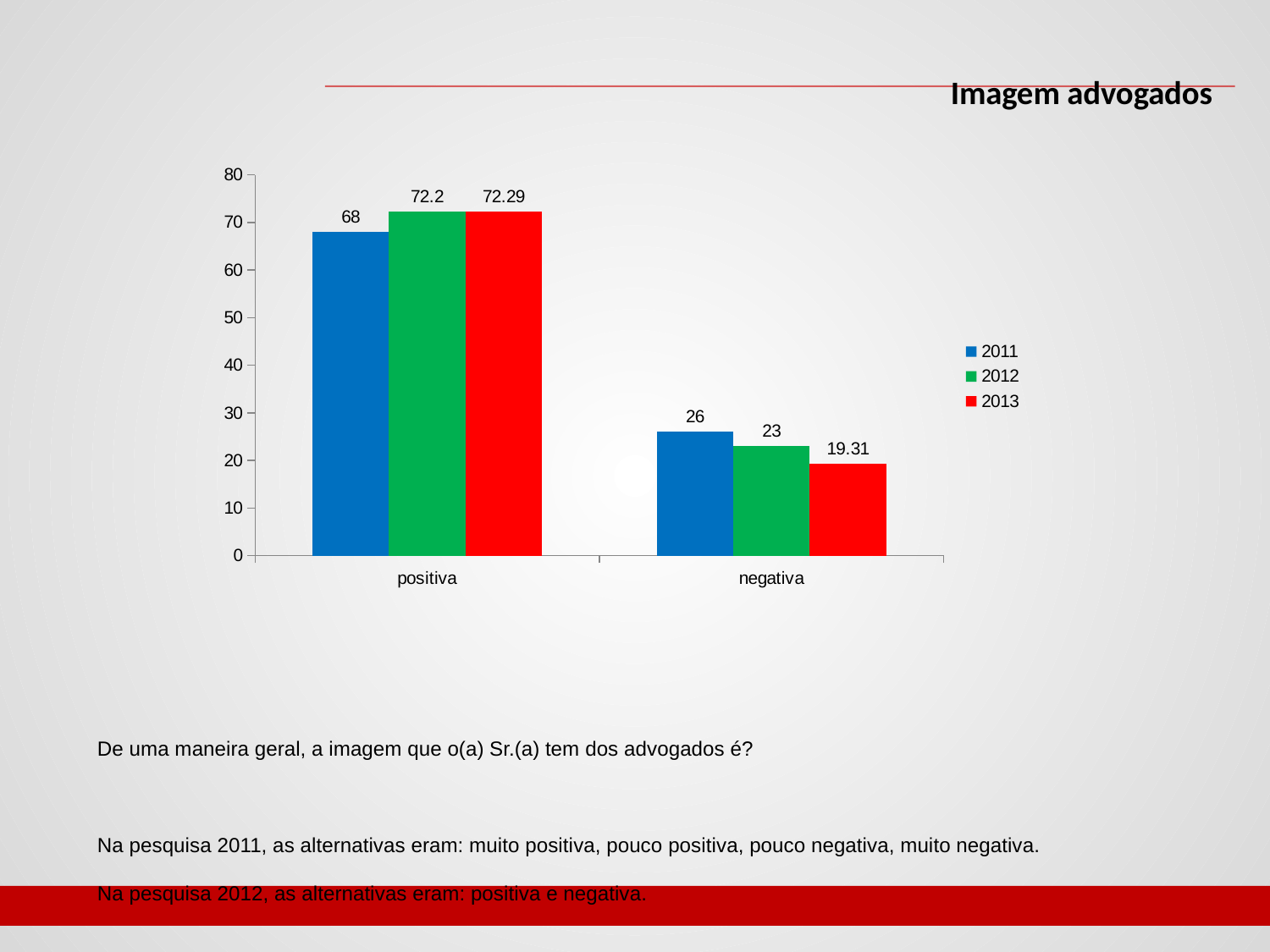
Which is larger: the 2012 value for 'negativa' or the 2013 value for 'negativa'? 2012 What is the value for 2013 in the 'negativa' category? 19.31 How many categories are shown on the x axis? 2 What is the title of the slide? Imagem advogados Which year has the lowest value in the 'positiva' category? 2011 What kind of chart is shown on the slide? bar chart What is the value for 2012 in the 'positiva' category? 72.2 What colour represents the 2013 series? red What is the difference between the 2011 and 2012 values in the 'negativa' category? 3 How many series does the legend list? 3 What is the value for 2011 in the 'positiva' category? 68 Which year has the highest value in the 'negativa' category? 2011